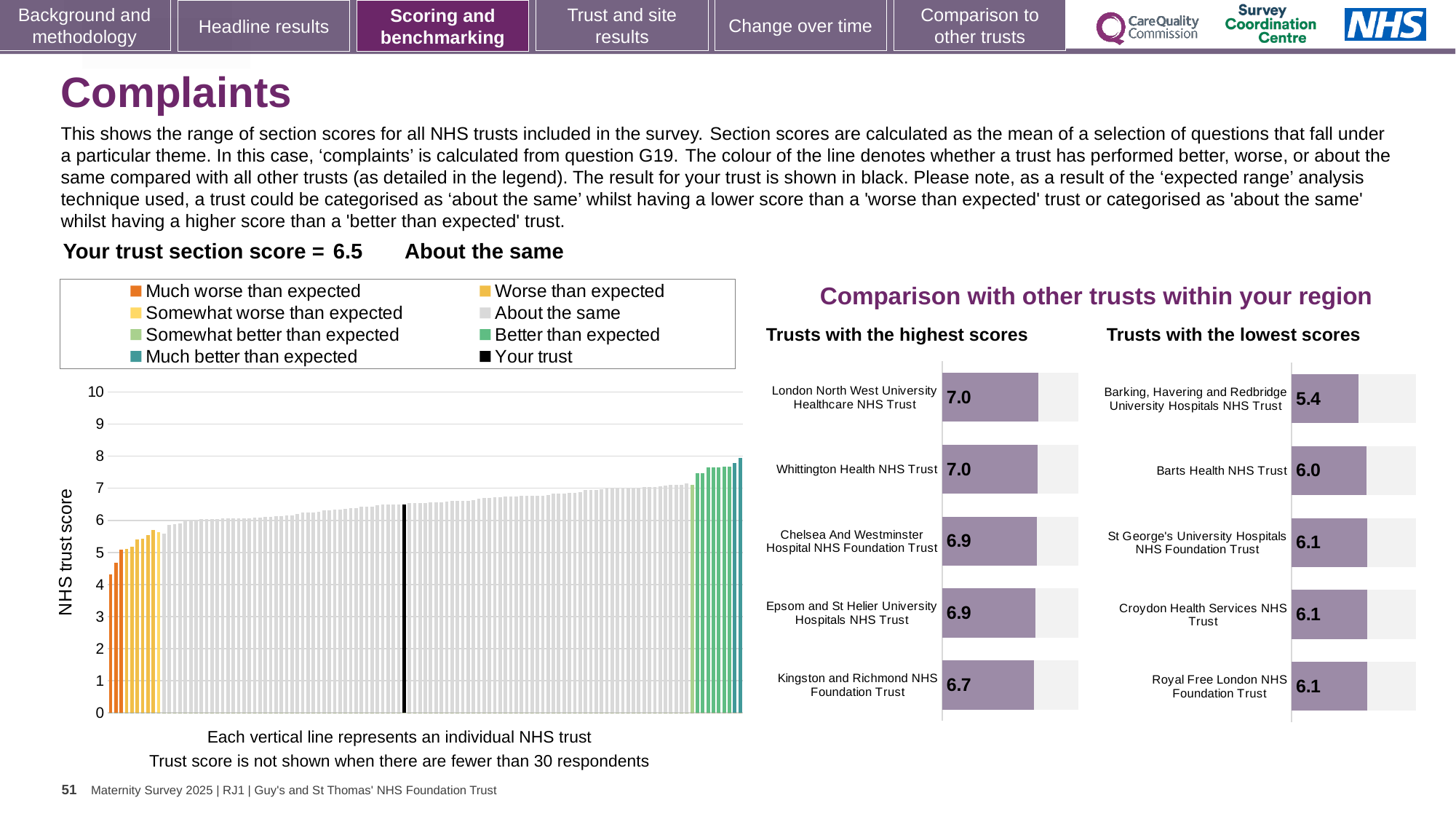
In the 'Trusts with the lowest scores' chart, which has the higher score: Barts Health NHS Trust or Croydon Health Services NHS Trust? Croydon Health Services NHS Trust In the 'Trusts with the lowest scores' chart, what is the difference between the scores for Barts Health NHS Trust and Barking, Havering and Redbridge University Hospitals NHS Trust? 0.6 In the NHS trust score chart on the left, do the bar values rise or fall from left to right? rise In the 'Trusts with the highest scores' chart, what is the score for London North West University Healthcare NHS Trust? 7.0 In the 'Trusts with the highest scores' chart, what is the difference between the scores for Whittington Health NHS Trust and Kingston and Richmond NHS Foundation Trust? 0.3 In the 'Trusts with the highest scores' chart, which trust has the lowest score shown? Kingston and Richmond NHS Foundation Trust How many trusts are listed in the 'Trusts with the highest scores' chart? 5 How many entries does the legend of the NHS trust score chart on the left list? 8 In the 'Trusts with the lowest scores' chart, which trust has the lowest score? Barking, Havering and Redbridge University Hospitals NHS Trust In the 'Trusts with the highest scores' chart, what is the score for Kingston and Richmond NHS Foundation Trust? 6.7 In the 'Trusts with the lowest scores' chart, what is the score for Barking, Havering and Redbridge University Hospitals NHS Trust? 5.4 In the NHS trust score chart on the left, is the value for the black 'Your trust' bar greater or less than 7? less